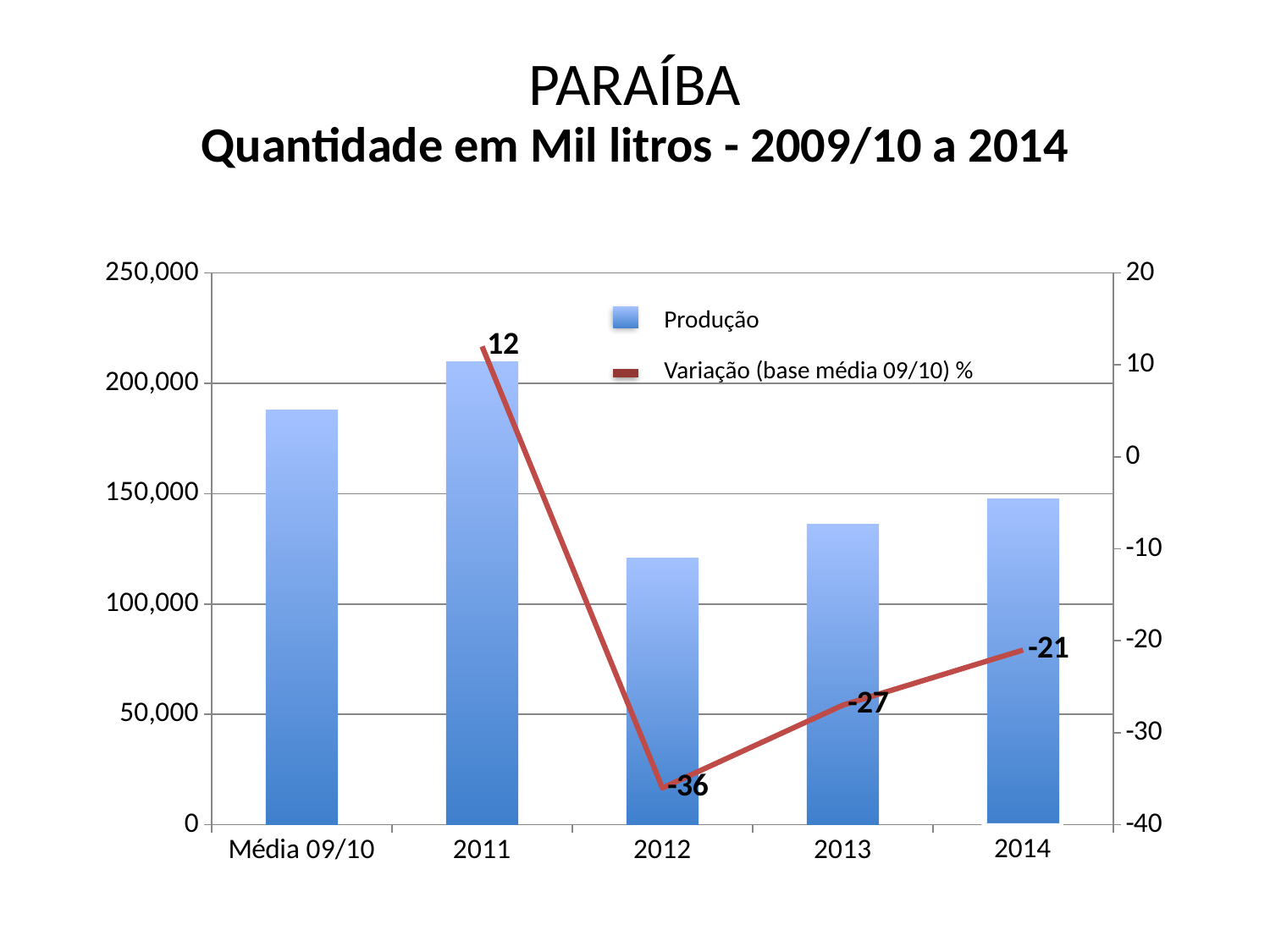
Is the Produção value for 2011 greater or less than 200,000? greater What is the value of Variação (base média 09/10) % for 2011? 12 Which is larger, the Produção bar for Média 09/10 or for 2014? Média 09/10 Which year has the highest Produção bar? 2011 How many categories are shown on the x axis? 5 What is the difference between the Variação values for 2013 and 2012? 9 Is the Produção value for 2013 greater or less than 150,000? less What is the value of Variação (base média 09/10) % for 2014? -21 Does the Variação line rise or fall from 2012 to 2014? rise Which year has the lowest Produção bar? 2012 How many series does the legend list? 2 What is the value of Variação (base média 09/10) % for 2012? -36